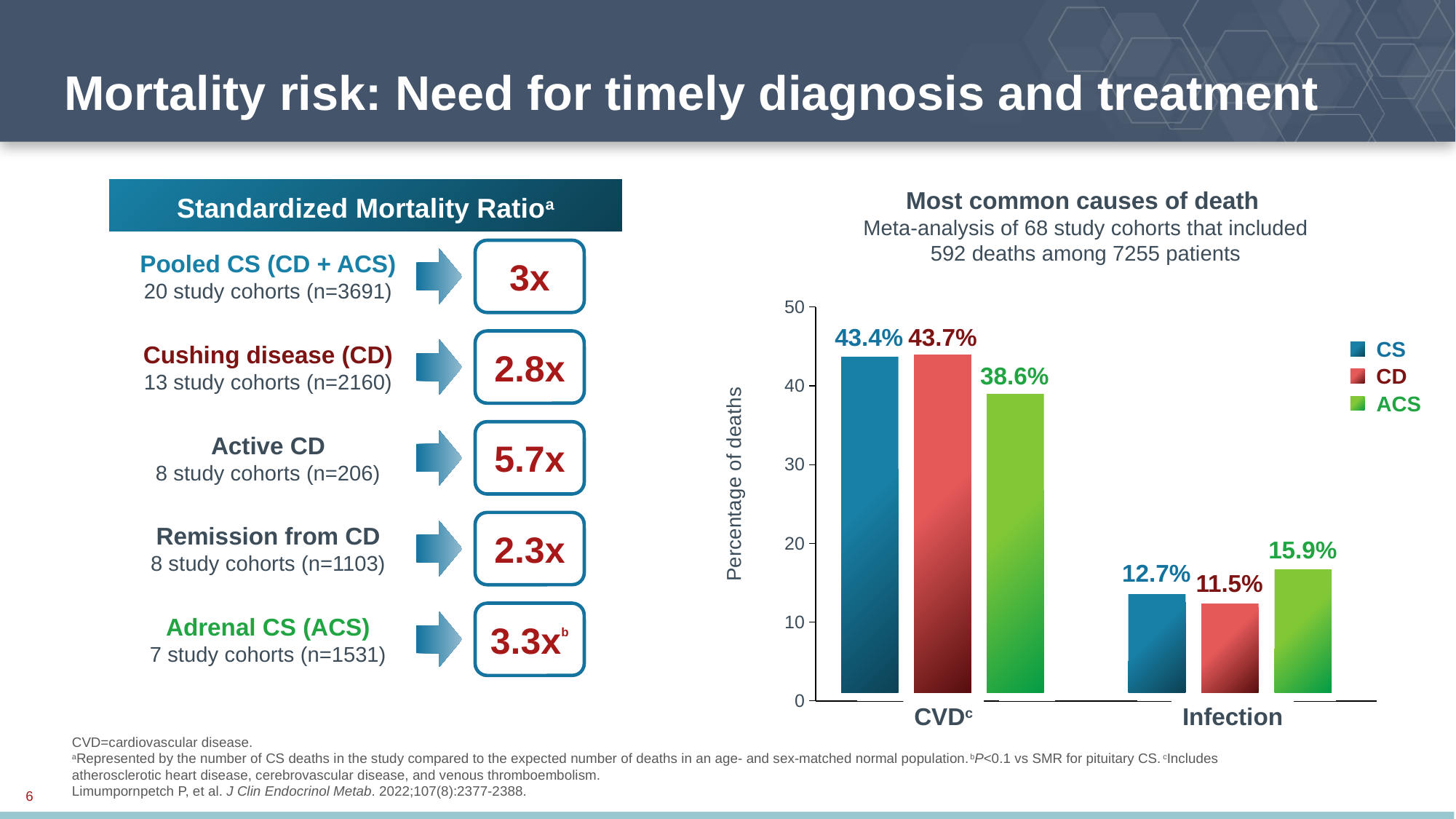
What type of chart is used to show the most common causes of death? bar chart In the most common causes of death chart, what percentage of deaths in the CD group were due to CVD? 43.7% In the most common causes of death chart, what percentage of deaths in the ACS group were due to infection? 15.9% In the most common causes of death chart, what is the difference between the ACS and CD percentages for infection? 4.4% What is the y-axis label of the most common causes of death chart? Percentage of deaths In the most common causes of death chart, what is the difference between the CS and ACS percentages for CVD? 4.8% How many series does the legend of the most common causes of death chart list? 3 In the most common causes of death chart, is the percentage of deaths due to infection higher for CS or for CD? CS In the most common causes of death chart, which series has the highest percentage of deaths due to infection? ACS In the most common causes of death chart, which series has the lowest percentage of deaths due to CVD? ACS In the most common causes of death chart, what percentage of deaths in the CS group were due to CVD? 43.4% In the most common causes of death chart, what percentage of deaths in the CD group were due to infection? 11.5%